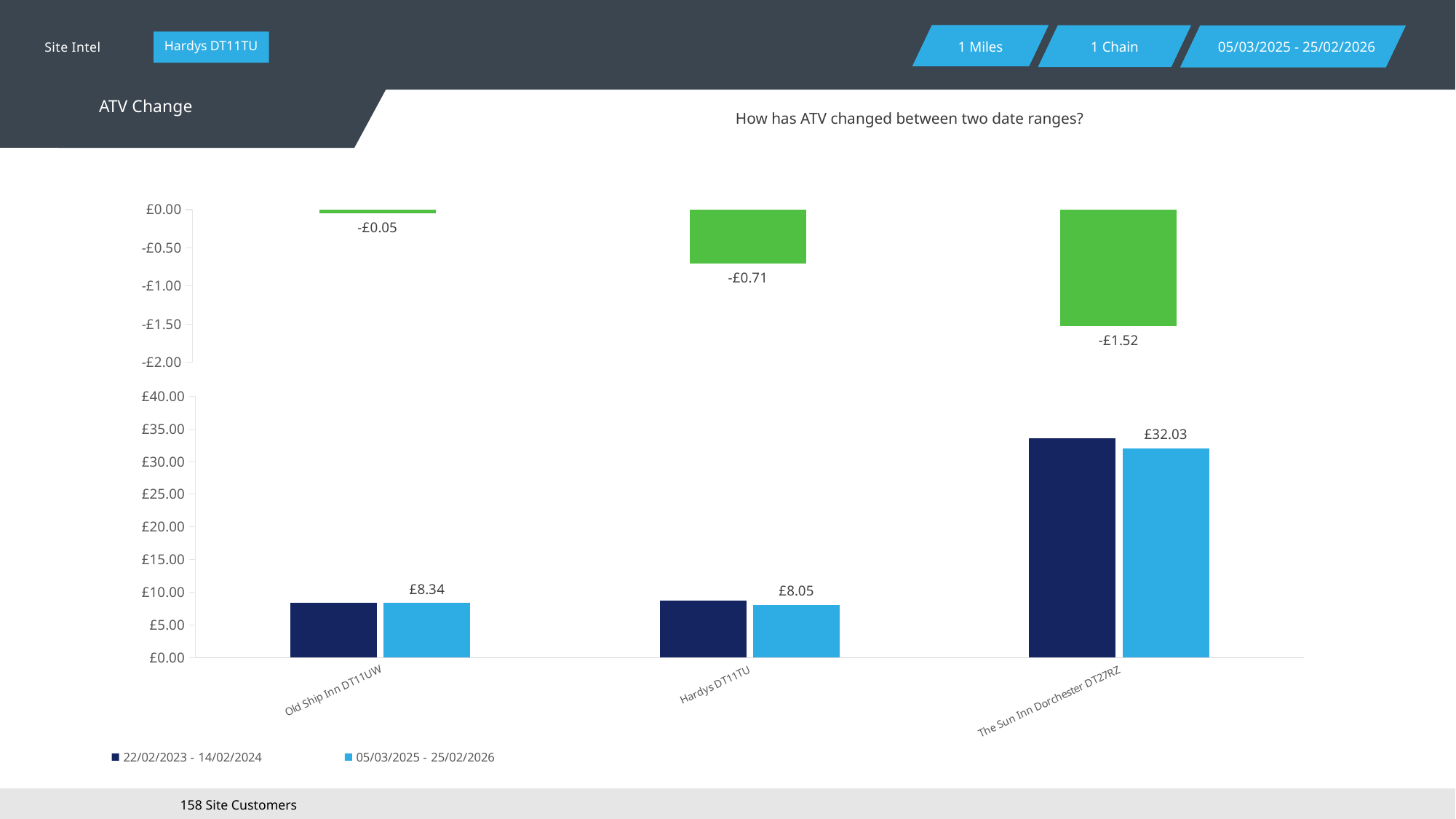
In the top chart, what is the ATV change for Old Ship Inn DT11UW? -£0.05 In the top chart, what is the ATV change for The Sun Inn Dorchester DT27RZ? -£1.52 In the bottom chart, what is the ATV for The Sun Inn Dorchester DT27RZ in the 05/03/2025 - 25/02/2026 period? £32.03 In the bottom chart, what is the ATV for Old Ship Inn DT11UW in the 05/03/2025 - 25/02/2026 period? £8.34 In the bottom chart, is the ATV for The Sun Inn Dorchester DT27RZ in the 22/02/2023 - 14/02/2024 period greater or less than £30.00? greater In the bottom chart, which site has the highest ATV in the 05/03/2025 - 25/02/2026 period? The Sun Inn Dorchester DT27RZ What type of chart is the bottom chart? bar chart In the top chart, which site has the largest decrease in ATV? The Sun Inn Dorchester DT27RZ How many series does the legend of the bottom chart list? 2 In the top chart, what is the difference between the ATV change for Hardys DT11TU and The Sun Inn Dorchester DT27RZ? £0.81 In the top chart, what is the ATV change for Hardys DT11TU? -£0.71 How many sites are shown in the top chart? 3